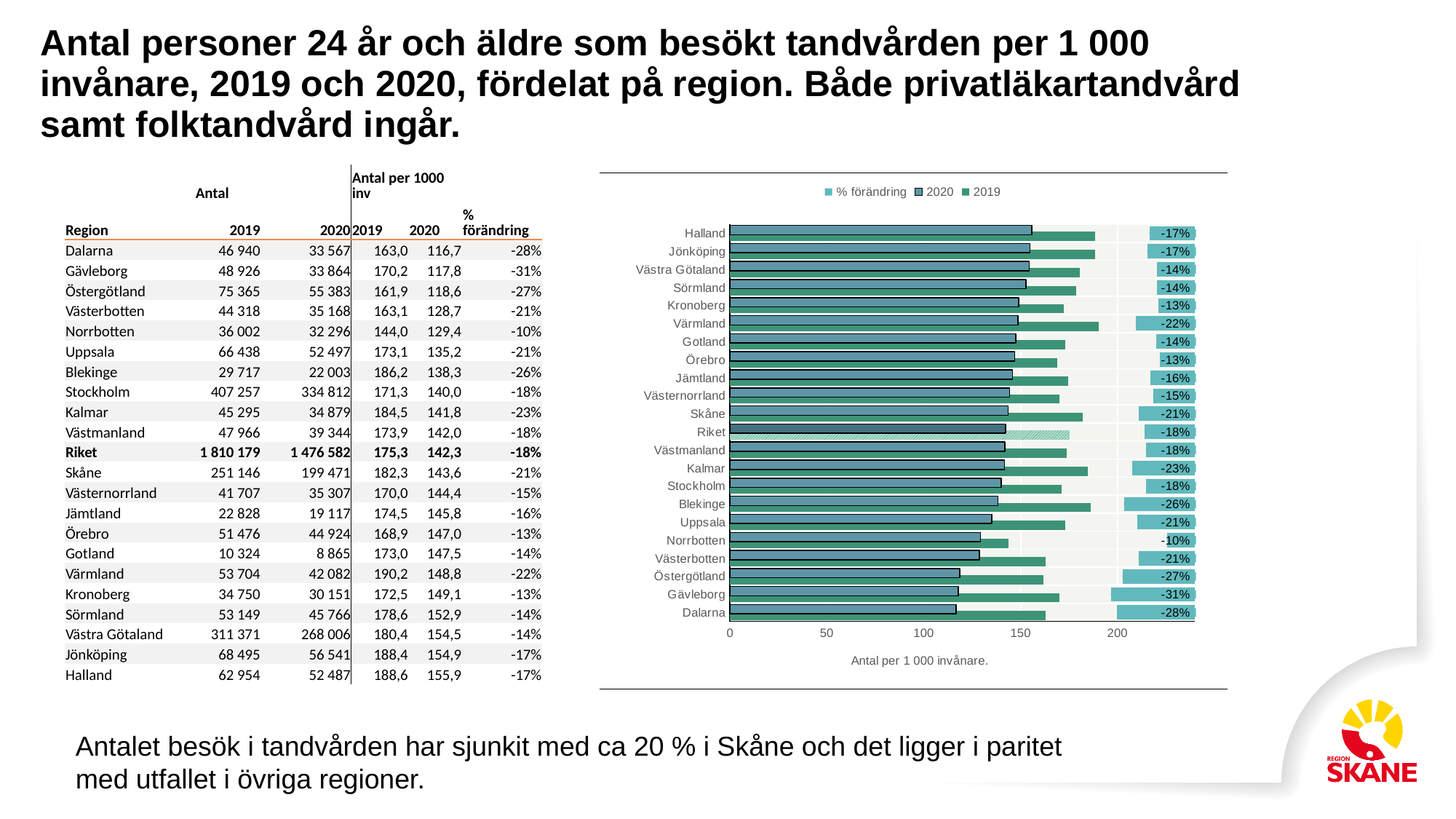
For Blekinge, which bar is longer, 2019 or 2020? 2019 How many series does the chart's legend list? 3 What is the difference in percentage points between the % förändring for Halland (-17%) and Dalarna (-28%)? 11 percentage points What is the % förändring value shown for Skåne on the chart? -21% What is the % förändring value shown for Gävleborg on the chart? -31% What kind of chart is shown on the slide? bar chart Is the 2020 bar for Dalarna greater or less than 150? less Is the 2020 bar for Halland greater or less than 150? greater What is the title of the chart's horizontal axis? Antal per 1 000 invånare. Which region has the smallest percentage decrease (least negative % förändring) on the chart? Norrbotten How many regions (including Riket) are plotted on the chart? 22 Which region has the largest percentage decrease (most negative % förändring) on the chart? Gävleborg